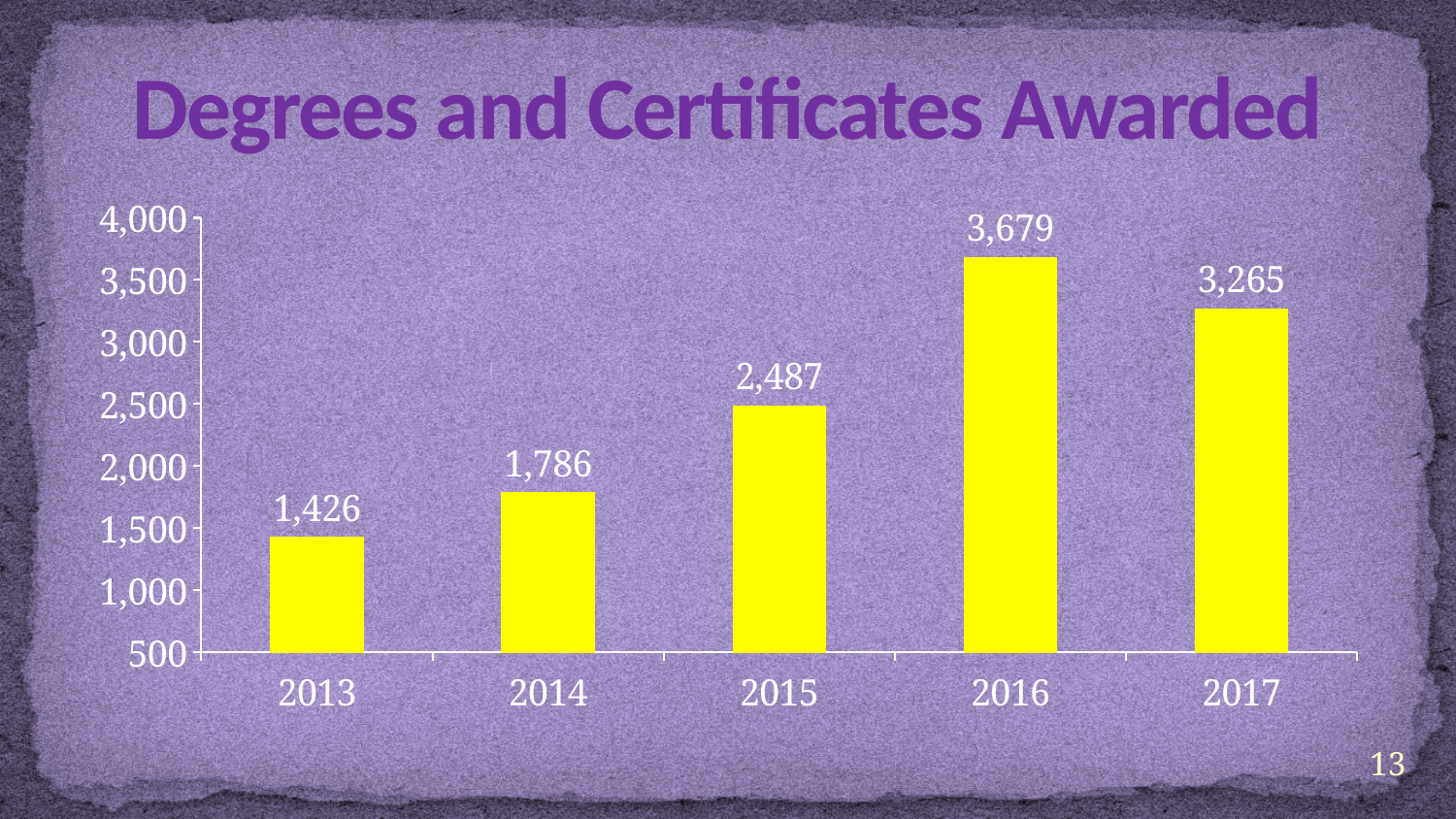
What is the value for 2017? 3,265 What is the difference between the values for 2016 and 2017? 414 Is the value for 2015 greater or less than 2,000? greater What is the title of the chart? Degrees and Certificates Awarded Which is larger, the value for 2015 or the value for 2017? 2017 What is the difference between the values for 2014 and 2013? 360 Which year has the lowest value? 2013 What kind of chart is shown on the slide? bar chart What is the value for 2016? 3,679 What is the value for 2013? 1,426 How many years are shown on the x axis? 5 Which year has the highest value? 2016